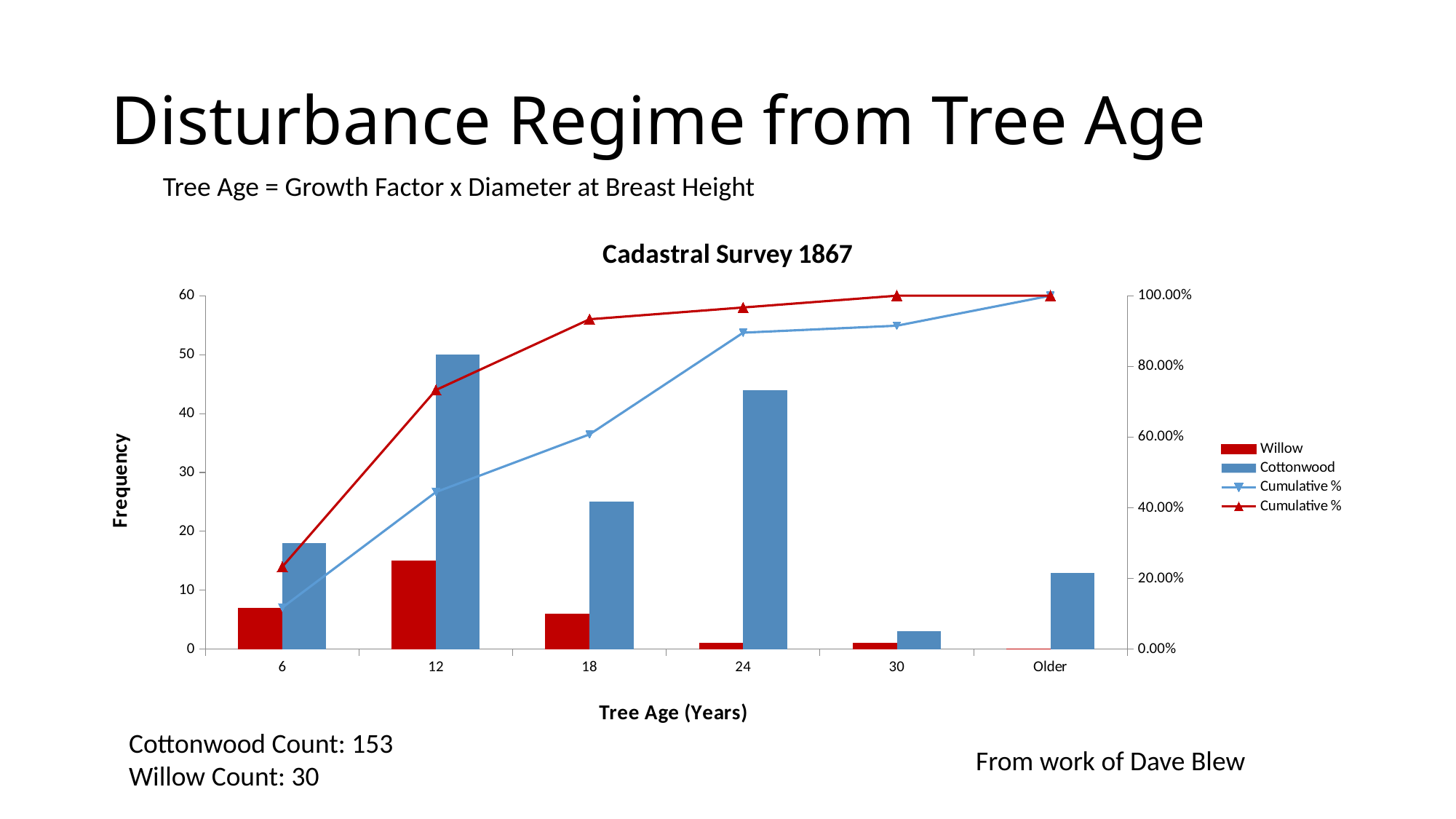
What is the label of the vertical axis on the left? Frequency At which tree age is the Cottonwood bar highest? 12 How many tree age categories are shown on the x axis? 6 What is the title of the chart? Cadastral Survey 1867 Is the Willow value at tree age 12 greater or less than 10? greater At which tree age is the Willow bar highest? 12 Is the Cottonwood value at tree age 24 greater or less than 40? greater Is the Willow value at tree age 6 greater or less than 10? less How many entries does the chart legend list? 4 Do the Cumulative % lines rise or fall as tree age increases along the x axis? rise At tree age 24, which is larger, the Willow bar or the Cottonwood bar? Cottonwood